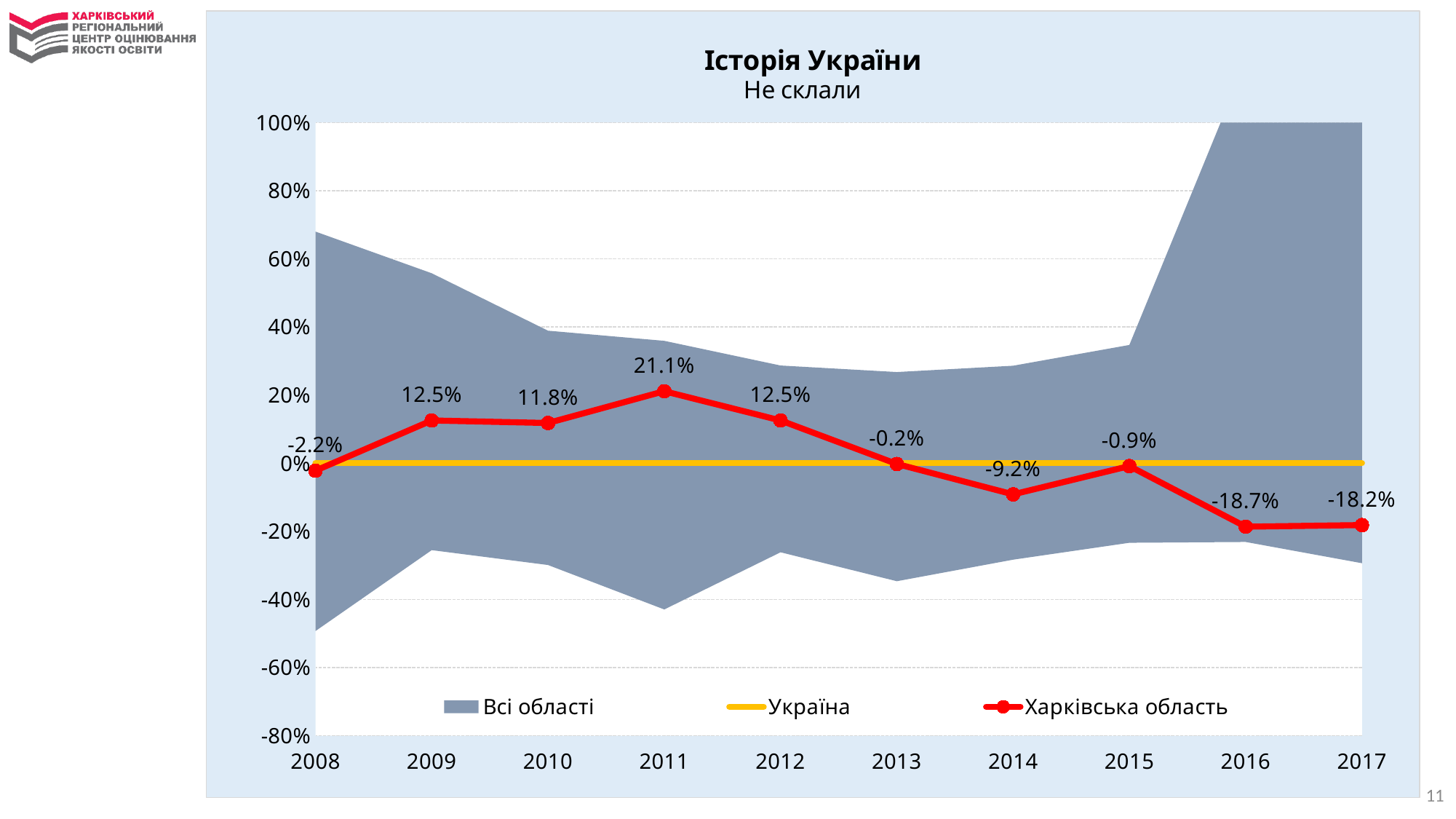
In which year is the value for Харківська область lowest? 2016 What is the value for Харківська область in 2008? -2.2% What kind of chart is this? combination area and line chart How many series does the legend list? 3 What is the title of the chart? Історія України What is the value for Харківська область in 2011? 21.1% How many years are shown on the x axis? 10 Does the value for Харківська область rise or fall from 2015 to 2016? fall What is the difference between the Харківська область values for 2011 and 2010? 9.3% What is the value for Харківська область in 2016? -18.7% Which is larger for Харківська область: the value in 2009 or the value in 2014? 2009 In which year is the value for Харківська область highest? 2011